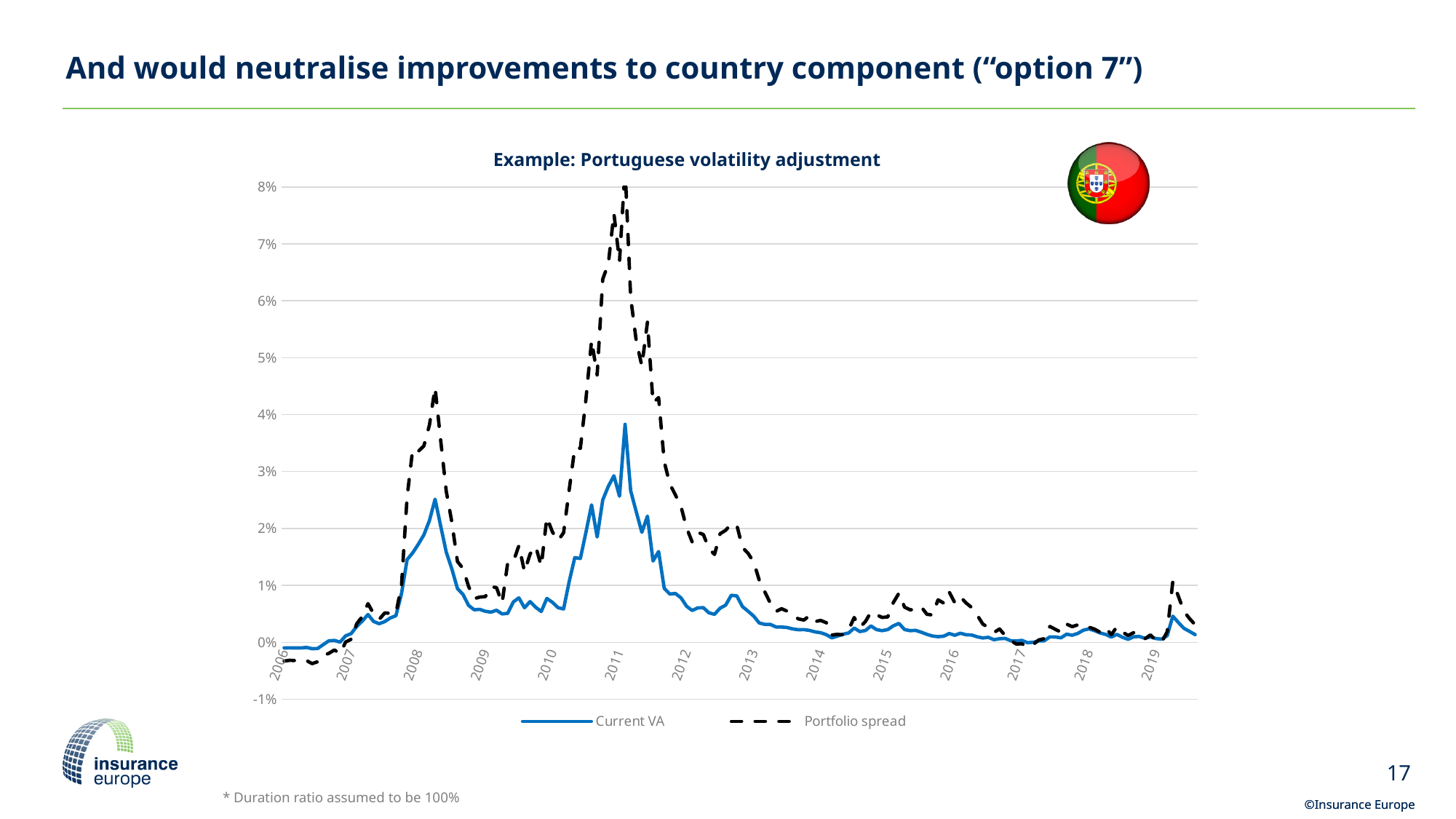
How many series does the legend list? 2 What kind of chart is shown on the slide? Line chart Do the values of both series rise or fall between the 2011 peak and 2014? fall What is the title of the chart? Example: Portuguese volatility adjustment Is the peak value of Current VA around 2011 greater or less than 3%? greater Around which year does the Portfolio spread reach its highest peak? 2011 Which series is drawn as a dashed black line? Portfolio spread Is the peak value of Portfolio spread around 2008 greater or less than 4%? greater Which series reaches the highest value on the chart? Portfolio spread Is the peak value of Portfolio spread around 2011 greater or less than 7%? greater How many year labels are shown on the x axis? 14 At the 2011 peak, which series is higher, Current VA or Portfolio spread? Portfolio spread